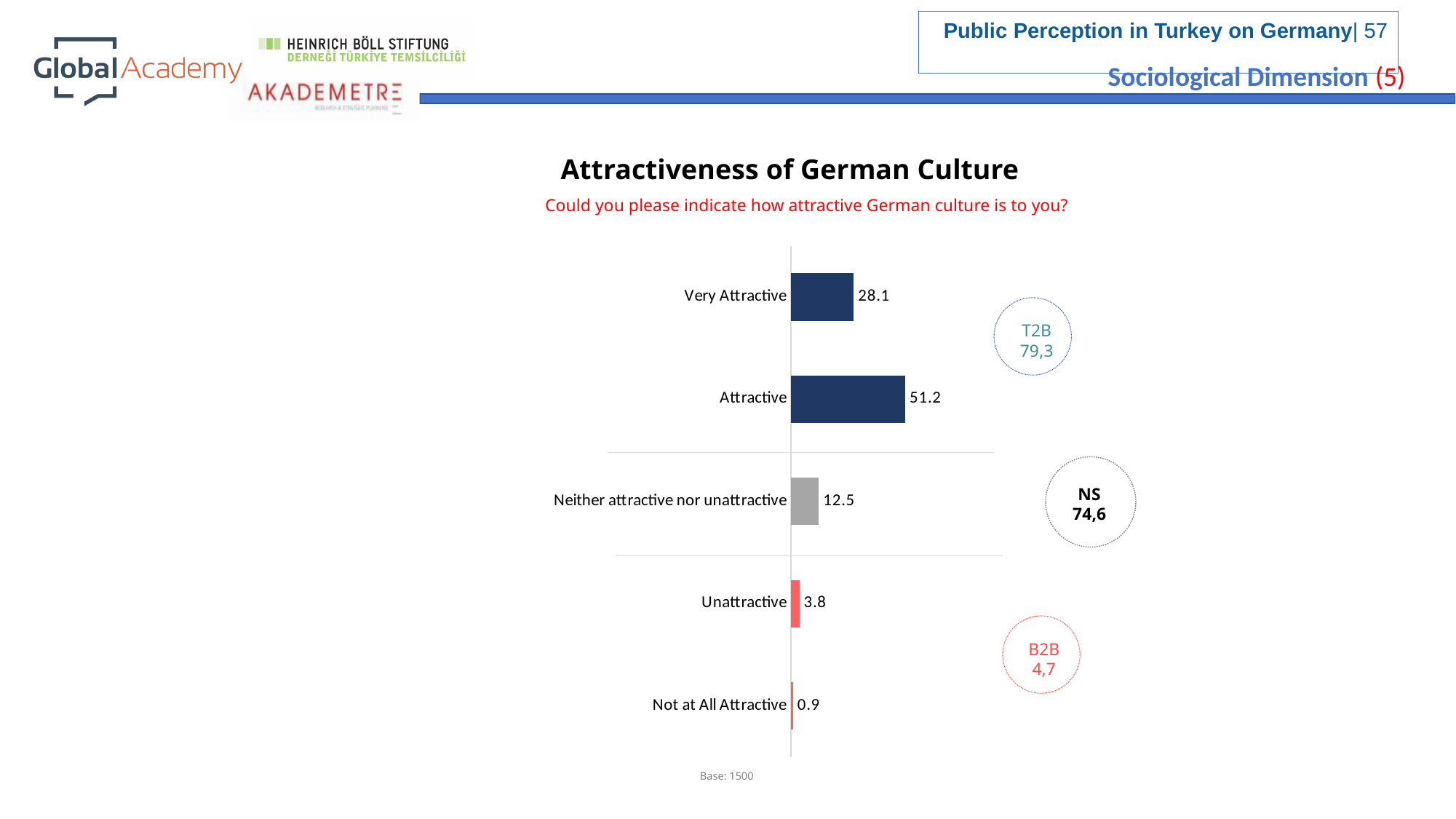
What kind of chart is shown on the slide? Bar chart What is the title of the chart? Attractiveness of German Culture What is the difference between the values for Attractive and Very Attractive? 23.1 What is the value for Neither attractive nor unattractive? 12.5 Which category has the highest value? Attractive What is the T2B value shown next to the chart? 79,3 Which category has the lowest value? Not at All Attractive What is the value for Not at All Attractive? 0.9 What is the value for Attractive? 51.2 How many categories are shown in the chart? 5 Which is larger, the value for Unattractive or the value for Neither attractive nor unattractive? Neither attractive nor unattractive What is the value for Very Attractive? 28.1